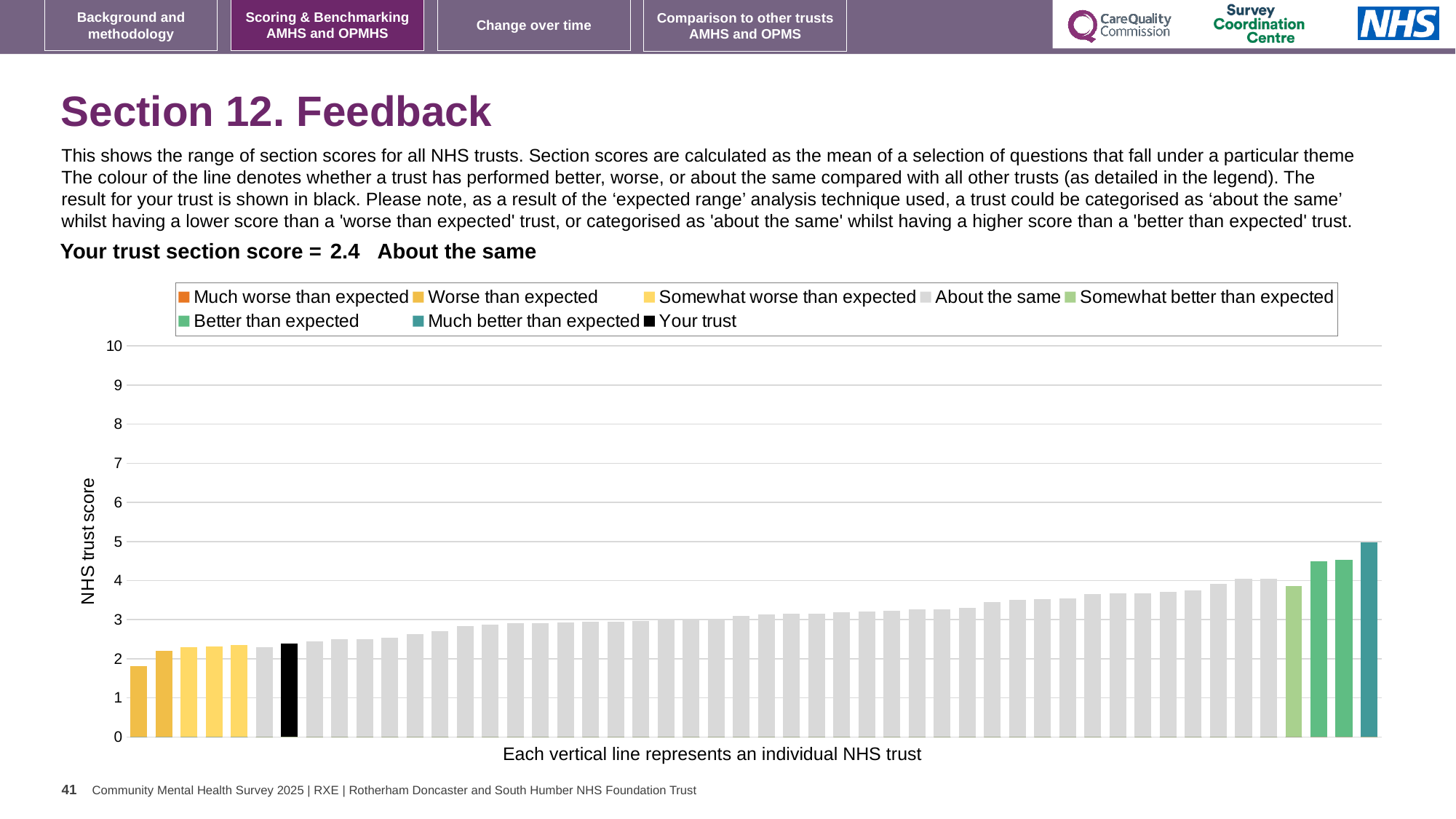
How many entries does the chart legend list? 8 Is the value of the tallest bar in the chart greater or less than 4? greater Is the value of the leftmost (shortest) bar greater or less than 2? less Is the value of the black 'Your trust' bar greater or less than 2? greater What is the label on the vertical axis of the chart? NHS trust score What colour is used for the 'Your trust' bar in the chart? black Do the bar values rise or fall from left to right along the x axis? rise What is the section score for your trust shown on the slide? 2.4 Which legend category does the tallest bar in the chart belong to? Much better than expected What kind of chart is shown on the slide? bar chart Which category is your trust's section score placed in according to the slide? About the same